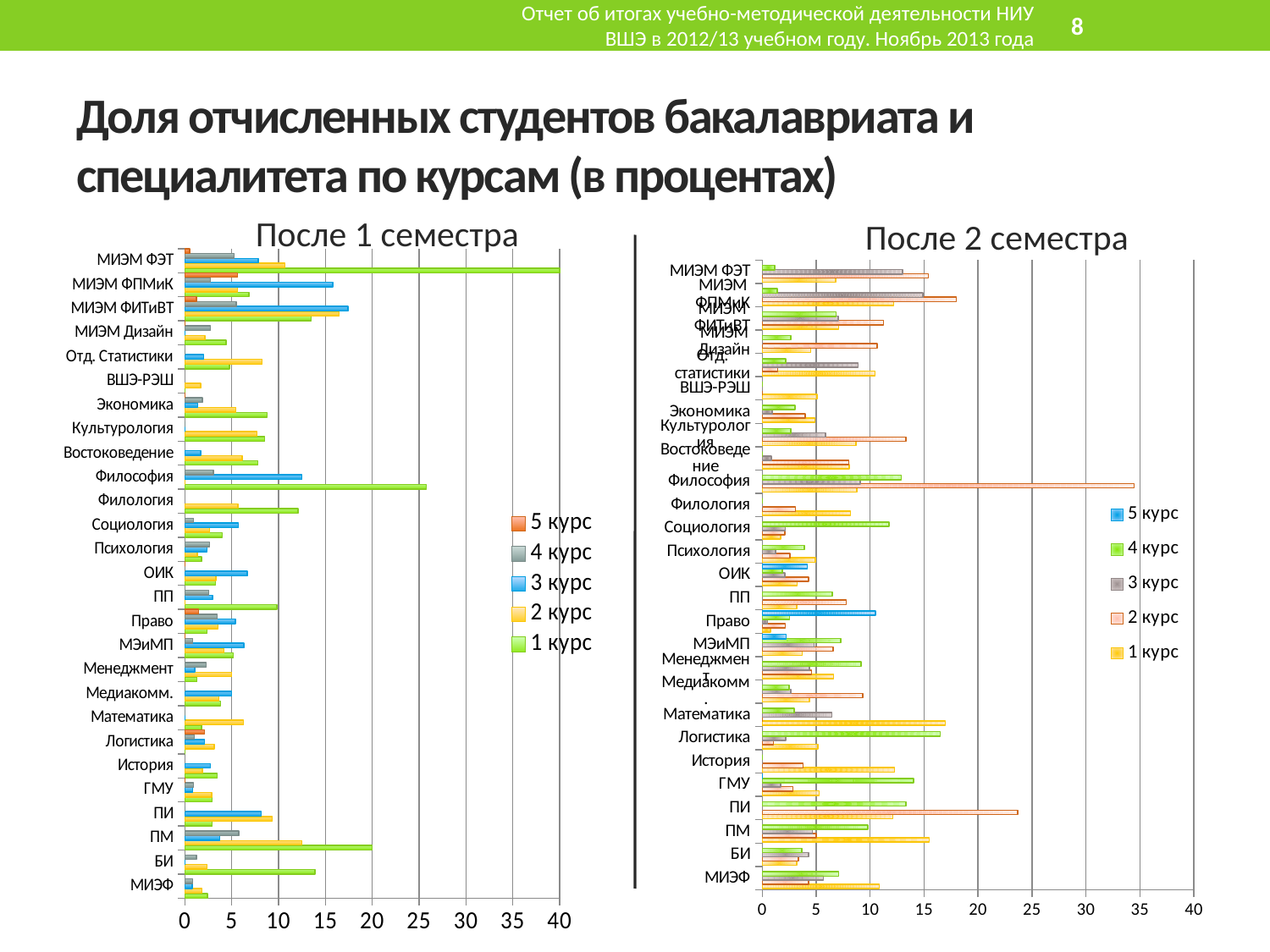
In the "После 2 семестра" chart, which is larger: the 2 курс value for Философия or the 2 курс value for ПИ? Философия In the "После 1 семестра" chart, which category has the longest bar overall? МИЭМ ФЭТ In the "После 1 семестра" chart, which is larger: the 1 курс value for МИЭМ ФЭТ or the 1 курс value for Философия? МИЭМ ФЭТ In the "После 1 семестра" chart, is the value of 1 курс for Философия greater or less than 25? greater In the "После 2 семестра" chart, is the value of 2 курс for ПИ greater or less than 20? greater What are the legend entries of the "После 1 семестра" chart? 5 курс, 4 курс, 3 курс, 2 курс, 1 курс How many series does the legend of the "После 2 семестра" chart list? 5 What kind of chart is the "После 1 семестра" chart? bar chart In the "После 1 семестра" chart, is the value of 3 курс for МИЭМ ФИТиВТ greater or less than 15? greater In the "После 2 семестра" chart, which category has the longest bar overall? Философия How many categories (faculties/programmes) are shown on the "После 1 семестра" chart? 27